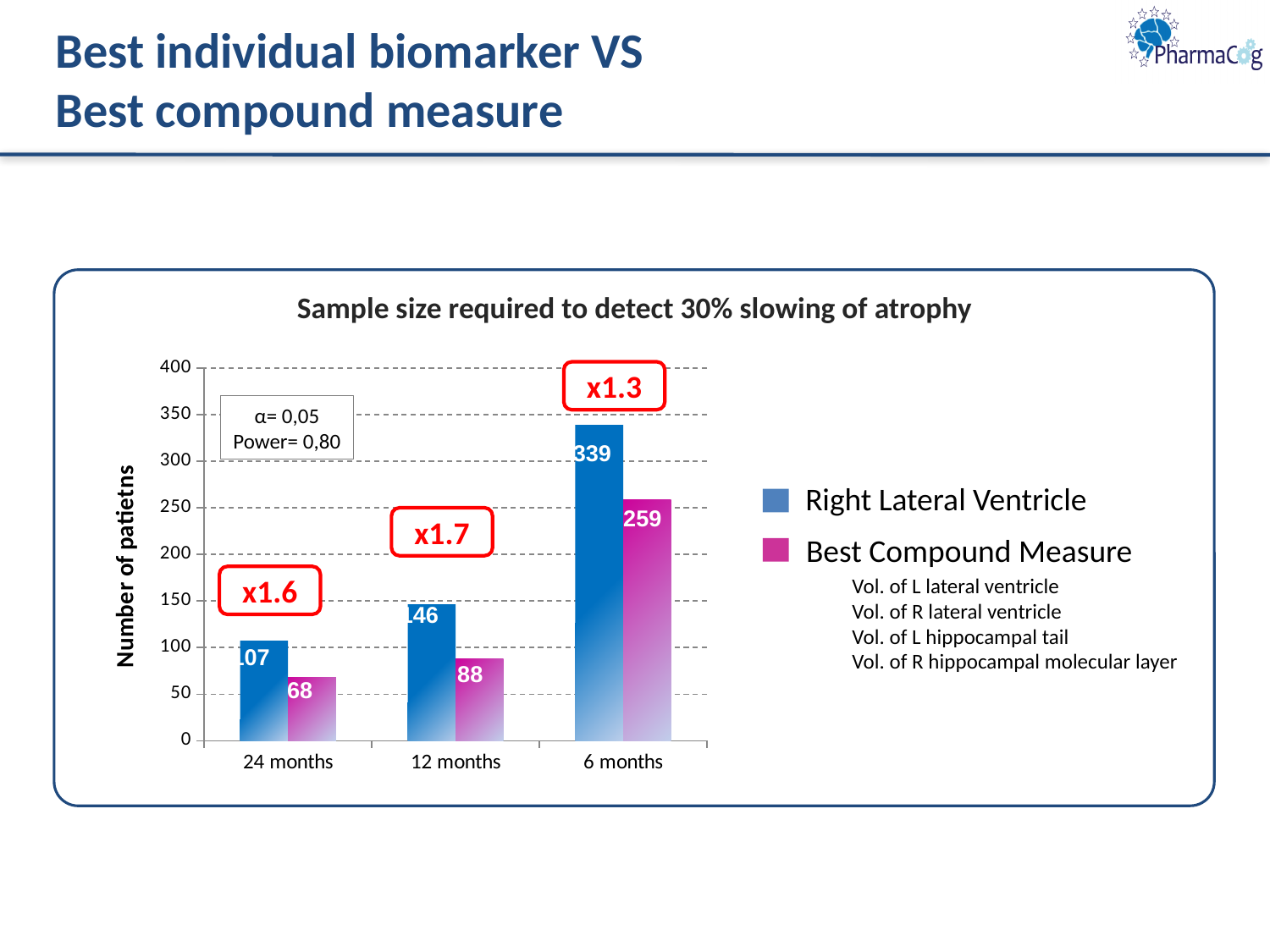
At 6 months, which series has the larger value, Right Lateral Ventricle or Best Compound Measure? Right Lateral Ventricle What is the value for Right Lateral Ventricle at 6 months? 339 What is the value for Best Compound Measure at 6 months? 259 What is the title of the chart? Sample size required to detect 30% slowing of atrophy What is the value for Best Compound Measure at 24 months? 68 Is the value for Right Lateral Ventricle at 12 months greater or less than 100? greater What is the difference between the Right Lateral Ventricle and Best Compound Measure values at 6 months? 80 How many time-point categories are shown on the x axis? 3 What is the value for Best Compound Measure at 12 months? 88 How many series does the legend list? 2 At which time point is the Best Compound Measure value highest? 6 months At which time point is the Best Compound Measure value lowest? 24 months